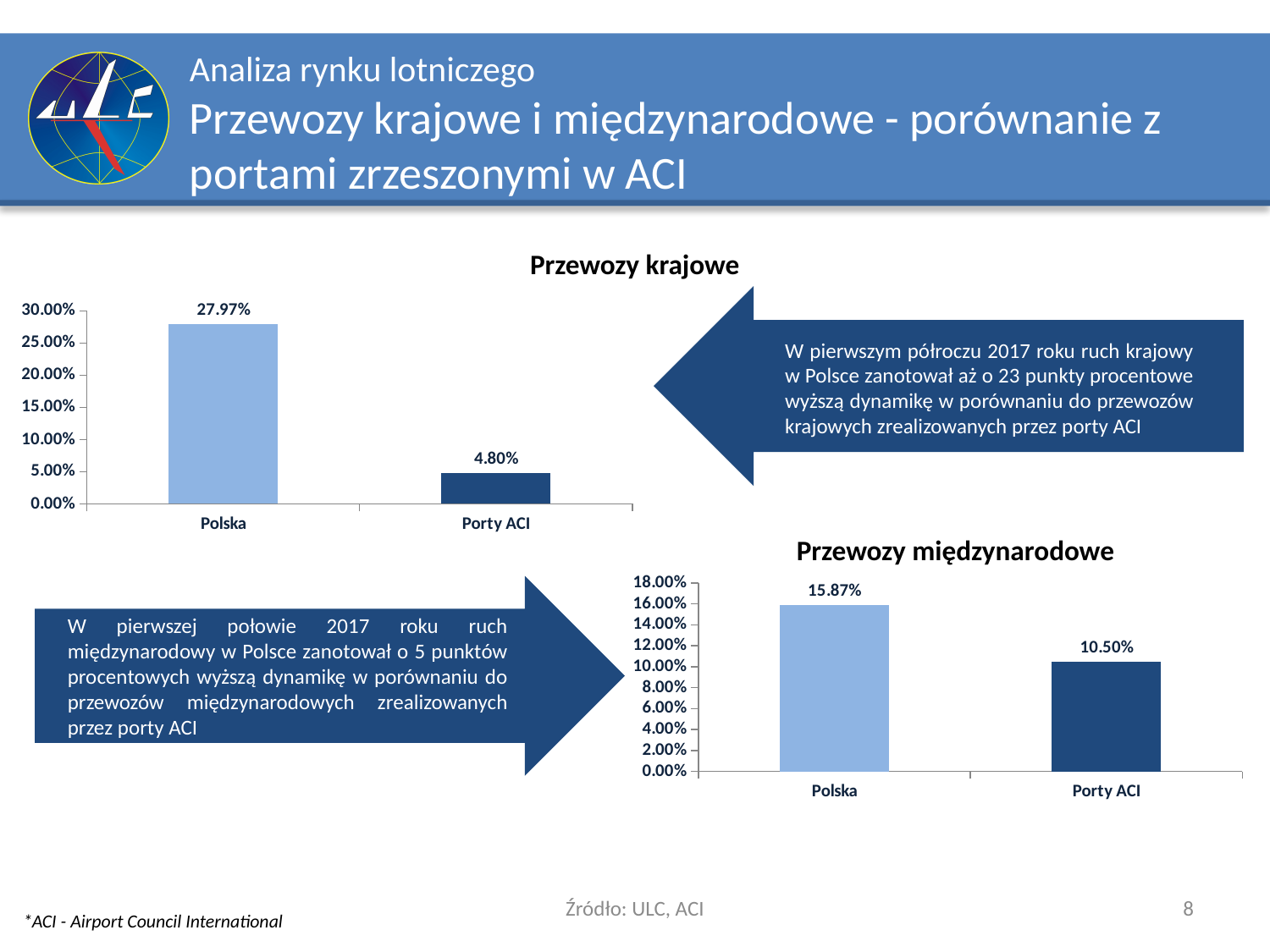
In the 'Przewozy międzynarodowe' chart, which is larger, the value for Polska or for Porty ACI? Polska In the 'Przewozy krajowe' chart, what is the difference between the values for Polska and Porty ACI? 23.17% In the 'Przewozy międzynarodowe' chart, what is the value for Polska? 15.87% In the 'Przewozy krajowe' chart, what is the value for Polska? 27.97% What type of chart is the 'Przewozy krajowe' chart? bar chart In the 'Przewozy krajowe' chart, what is the value for Porty ACI? 4.80% How many categories are shown in the 'Przewozy międzynarodowe' chart? 2 In the 'Przewozy międzynarodowe' chart, what is the difference between the values for Polska and Porty ACI? 5.37% In the 'Przewozy krajowe' chart, which category has the highest value? Polska In the 'Przewozy krajowe' chart, is the value for Porty ACI greater or less than 10.00%? less In the 'Przewozy międzynarodowe' chart, what is the value for Porty ACI? 10.50% In the 'Przewozy międzynarodowe' chart, which category has the lowest value? Porty ACI